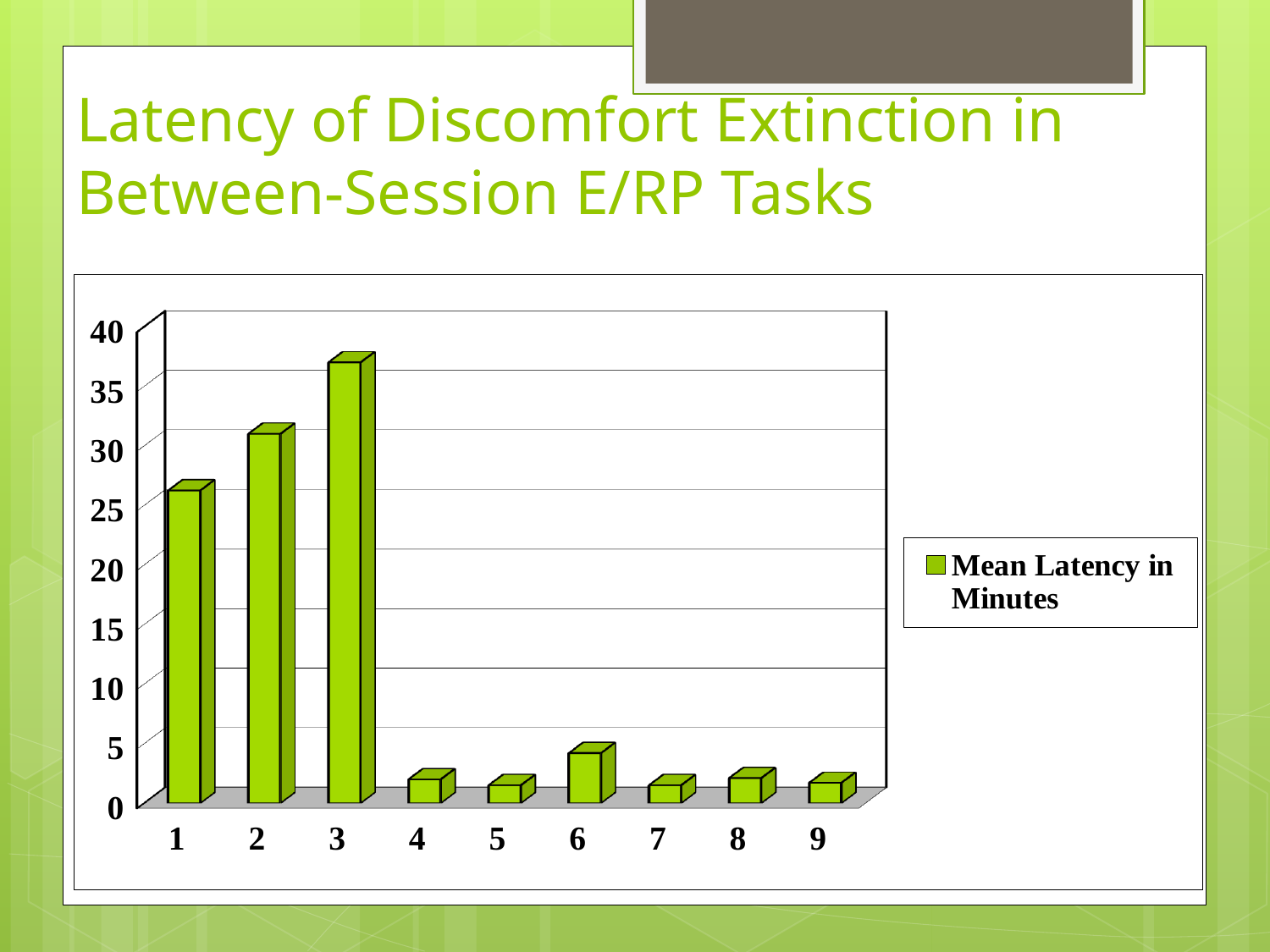
How many categories are shown on the x axis of the chart? 9 What kind of chart is shown on the slide? Bar chart Which category has the highest mean latency in the chart? 3 Do the values rise or fall from category 1 to category 3? rise Is the value for category 3 greater or less than 35? greater Which has the larger value, category 6 or category 4? 6 Is the value for category 1 greater or less than 20? greater What is the title of the slide containing the chart? Latency of Discomfort Extinction in Between-Session E/RP Tasks Is the value for category 6 greater or less than 5? less How many series does the chart's legend list? 1 What is the name of the series shown in the chart's legend? Mean Latency in Minutes Which has the larger value, category 2 or category 1? 2